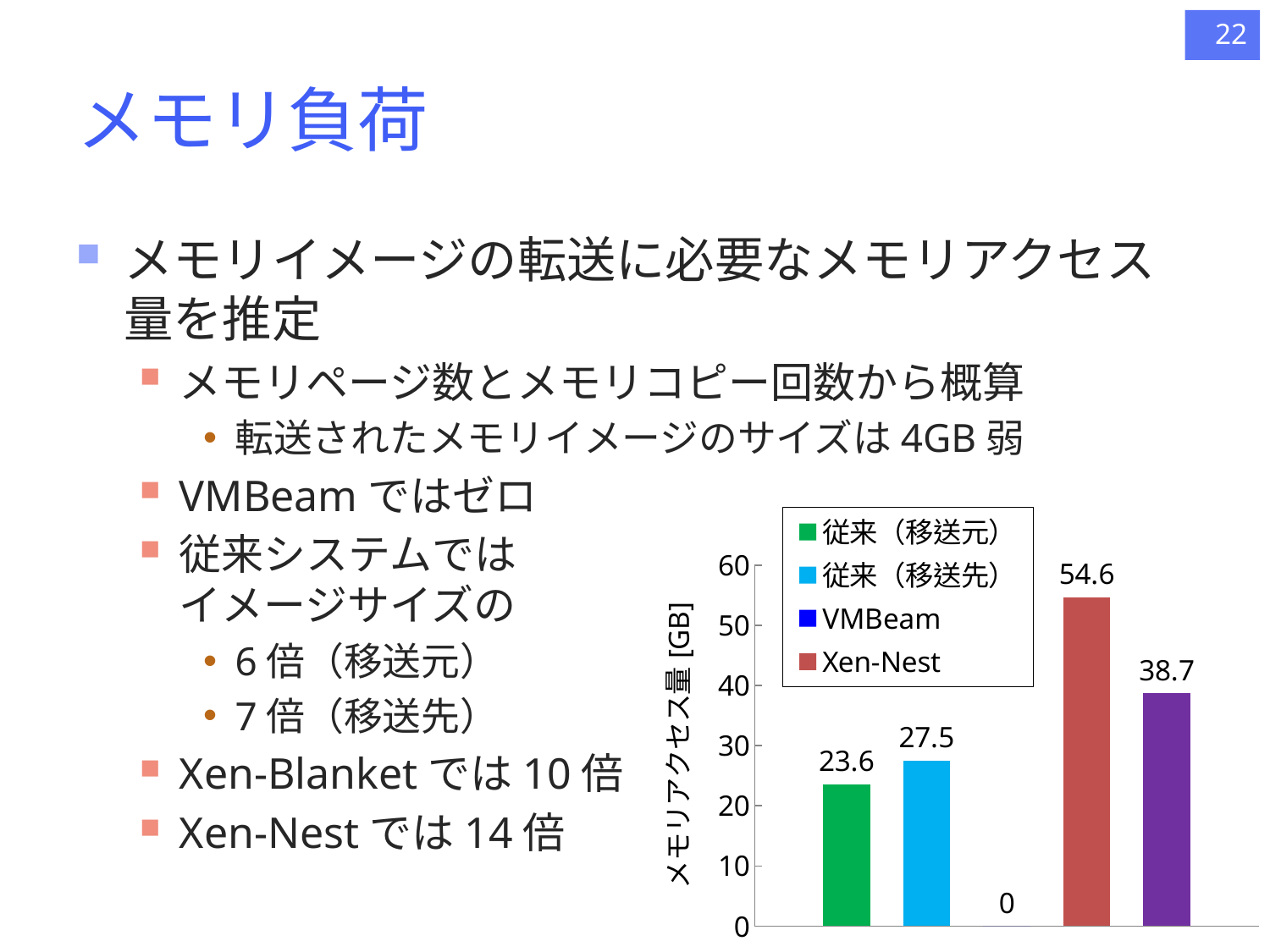
What value is printed above the purple bar? 38.7 What kind of chart is shown on the slide? bar chart What is the memory access amount shown for VMBeam? 0 How many series does the legend list? 4 What is the memory access amount for Xen-Nest in the chart? 54.6 What is the value of the 従来（移送先） bar? 27.5 How much larger is the Xen-Nest value than the 従来（移送元） value? 31 Which is larger, 従来（移送元） or 従来（移送先）? 従来（移送先） What is the label of the vertical axis? メモリアクセス量 [GB] What is the value of the 従来（移送元） bar? 23.6 Which legend series has the lowest memory access amount? VMBeam Which legend series has the highest memory access amount? Xen-Nest